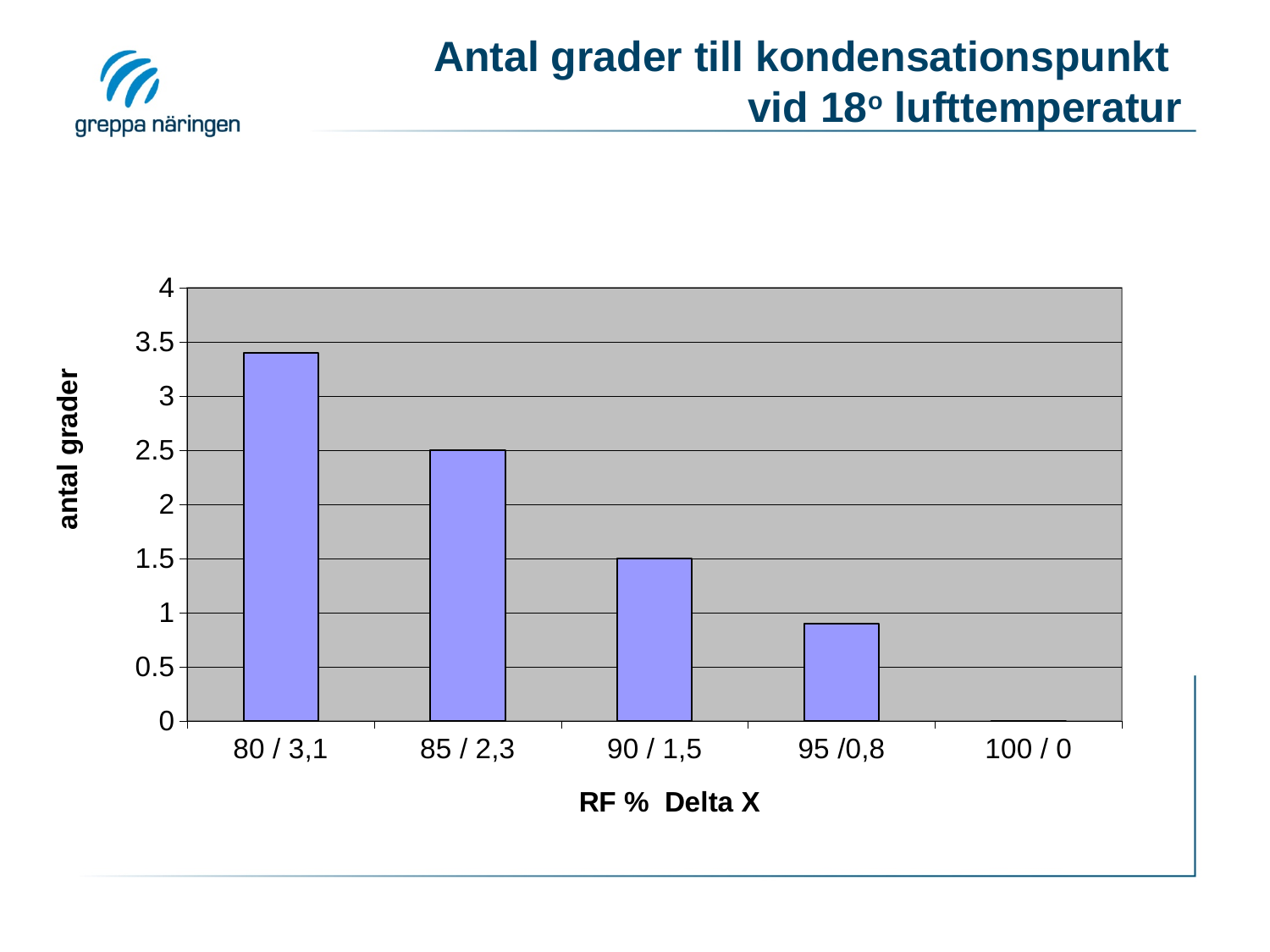
Which is larger, the value for 85 / 2,3 or the value for 90 / 1,5? 85 / 2,3 What is the value for 100 / 0? 0 Is the value for 80 / 3,1 greater or less than 3? greater Which category has the lowest bar? 100 / 0 How many categories are shown on the x axis of the chart? 5 What is the title of the y axis? antal grader Is the value for 95 /0,8 greater or less than 1? less Do the bar values rise or fall from left to right along the x axis? fall Which category has the highest bar? 80 / 3,1 What is the title of the x axis? RF % Delta X What kind of chart is shown on the slide? bar chart What is the value for 90 / 1,5? 1.5